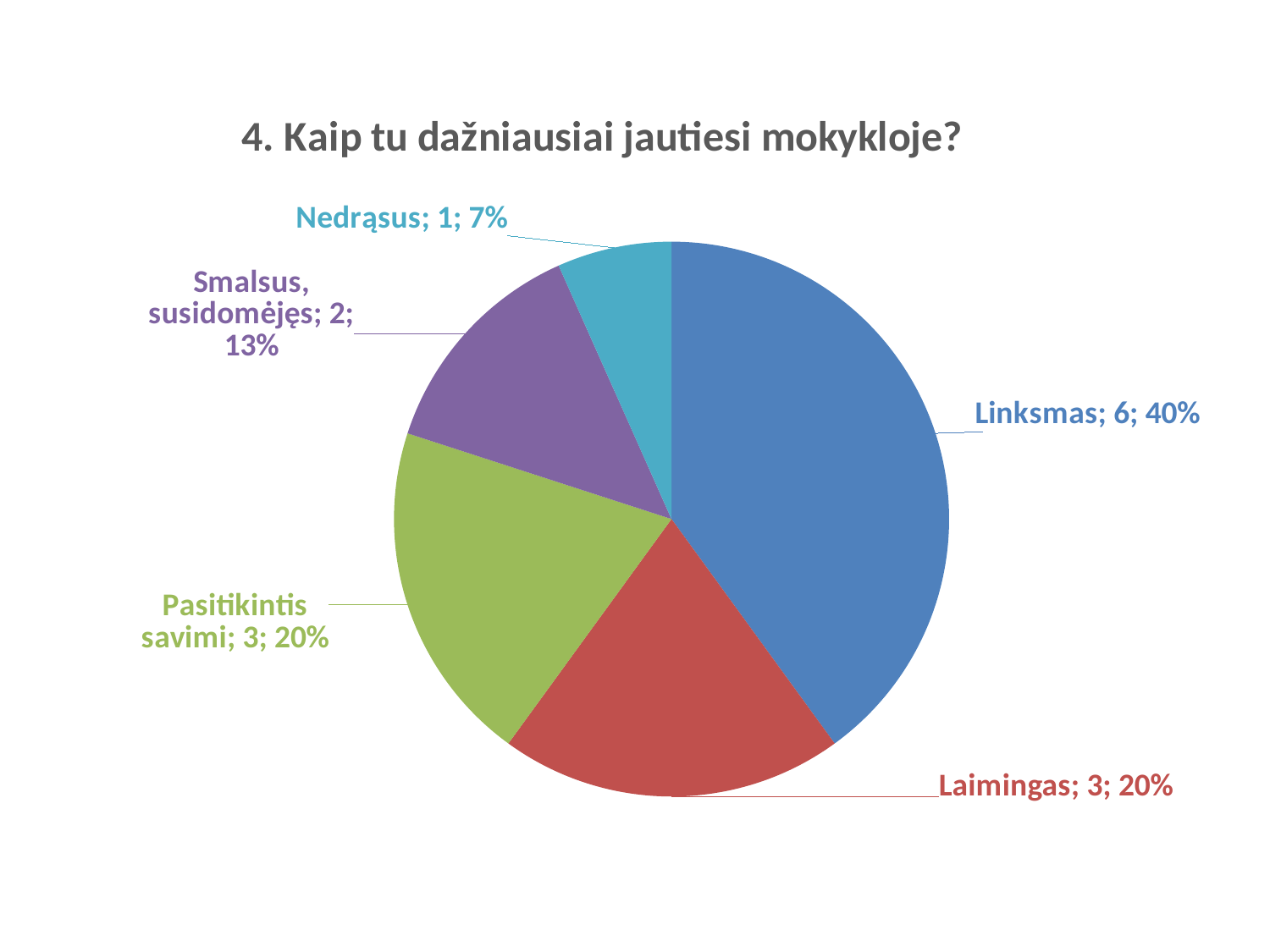
What is the count for Linksmas? 6 What is the difference in count between Linksmas and Laimingas? 3 Which category has the largest slice? Linksmas What percentage share does Linksmas have? 40% Which is larger, the count for Smalsus, susidomėjęs or the count for Pasitikintis savimi? Pasitikintis savimi What percentage share does Nedrąsus have? 7% What is the count for Smalsus, susidomėjęs? 2 What type of chart is shown on the slide? pie chart Which category has the smallest slice? Nedrąsus How many slices does the pie chart have? 5 What colour is the Laimingas slice? red What is the title of the chart? 4. Kaip tu dažniausiai jautiesi mokykloje?